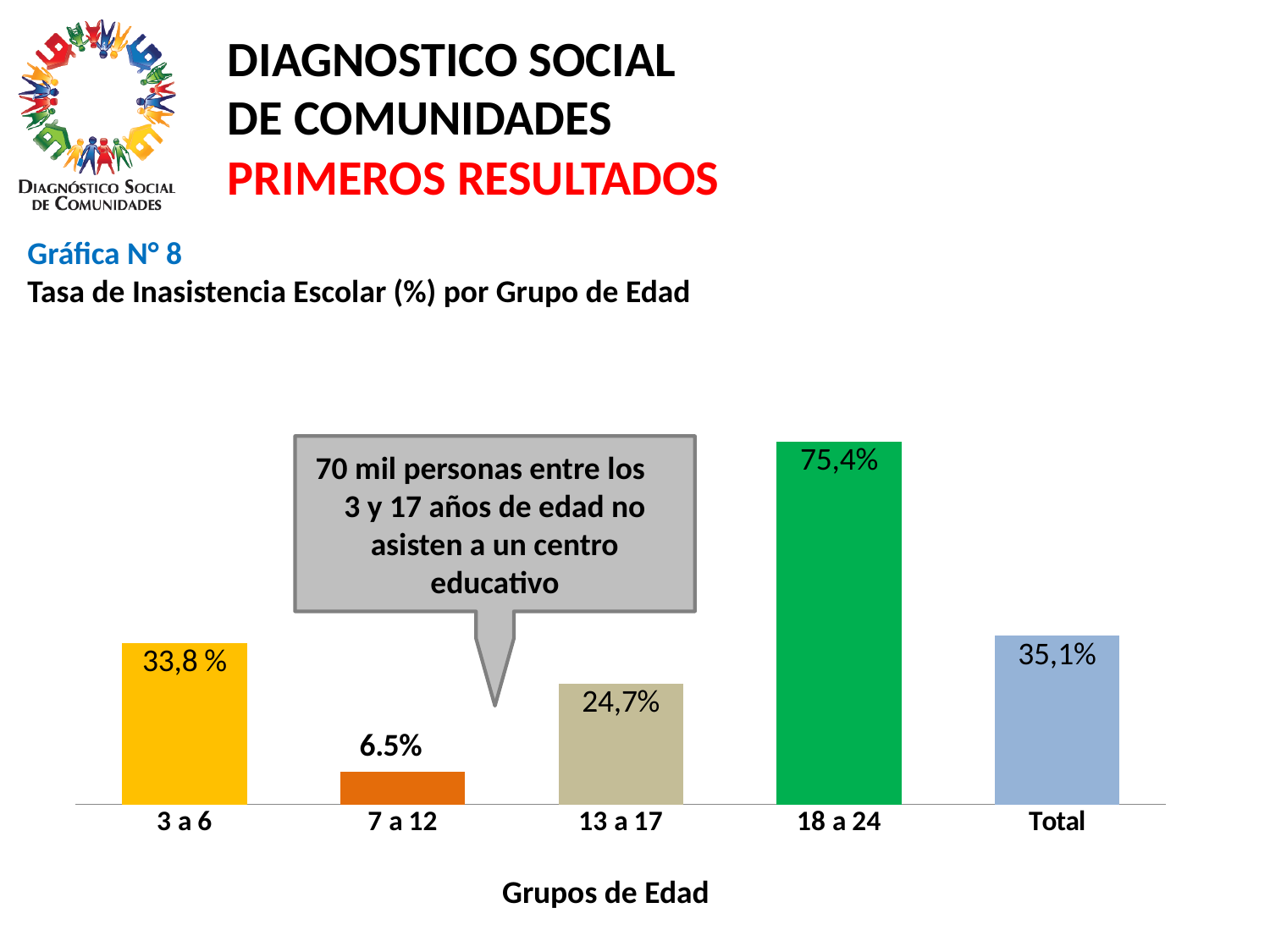
Which is larger, the value for 3 a 6 or the value for 13 a 17? 3 a 6 Which age group has the highest school non-attendance rate? 18 a 24 What is the value for the 13 a 17 age group? 24,7% What is the value shown for Total? 35,1% How many bars are shown in the chart? 5 What is the value for the 18 a 24 age group? 75,4% What is the difference between the Total value and the value for 13 a 17? 10,4% What is the value for the 7 a 12 age group? 6.5% What is the difference between the values for 18 a 24 and 3 a 6? 41,6% What is the value for the 3 a 6 age group? 33,8 % Which age group has the lowest school non-attendance rate? 7 a 12 What type of chart is shown on the slide? Bar chart